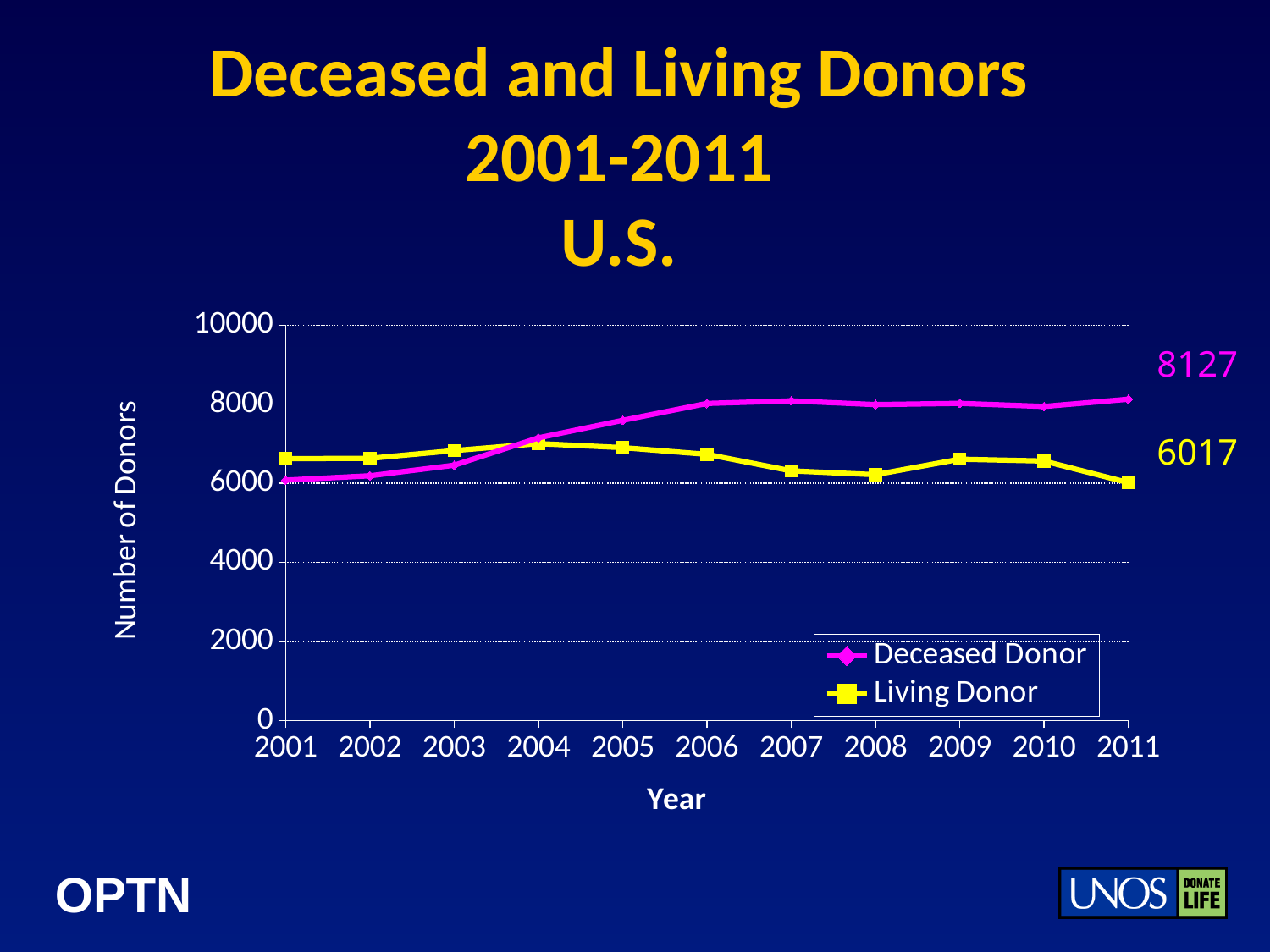
How many series does the legend list? 2 How many years are plotted on the x axis? 11 In 2001, which series has the larger value, Deceased Donor or Living Donor? Living Donor What is the value for Living Donor in 2011? 6017 What is the value for Deceased Donor in 2011? 8127 Is the value for Living Donor in 2008 greater or less than 8000? less What is the title of the y axis? Number of Donors What kind of chart is shown on the slide? line chart Does the Deceased Donor series rise or fall from 2001 to 2006? rise In 2011, which series has the larger value, Deceased Donor or Living Donor? Deceased Donor Is the value for Deceased Donor in 2001 greater or less than 8000? less What is the difference between the Deceased Donor and Living Donor values in 2011? 2110